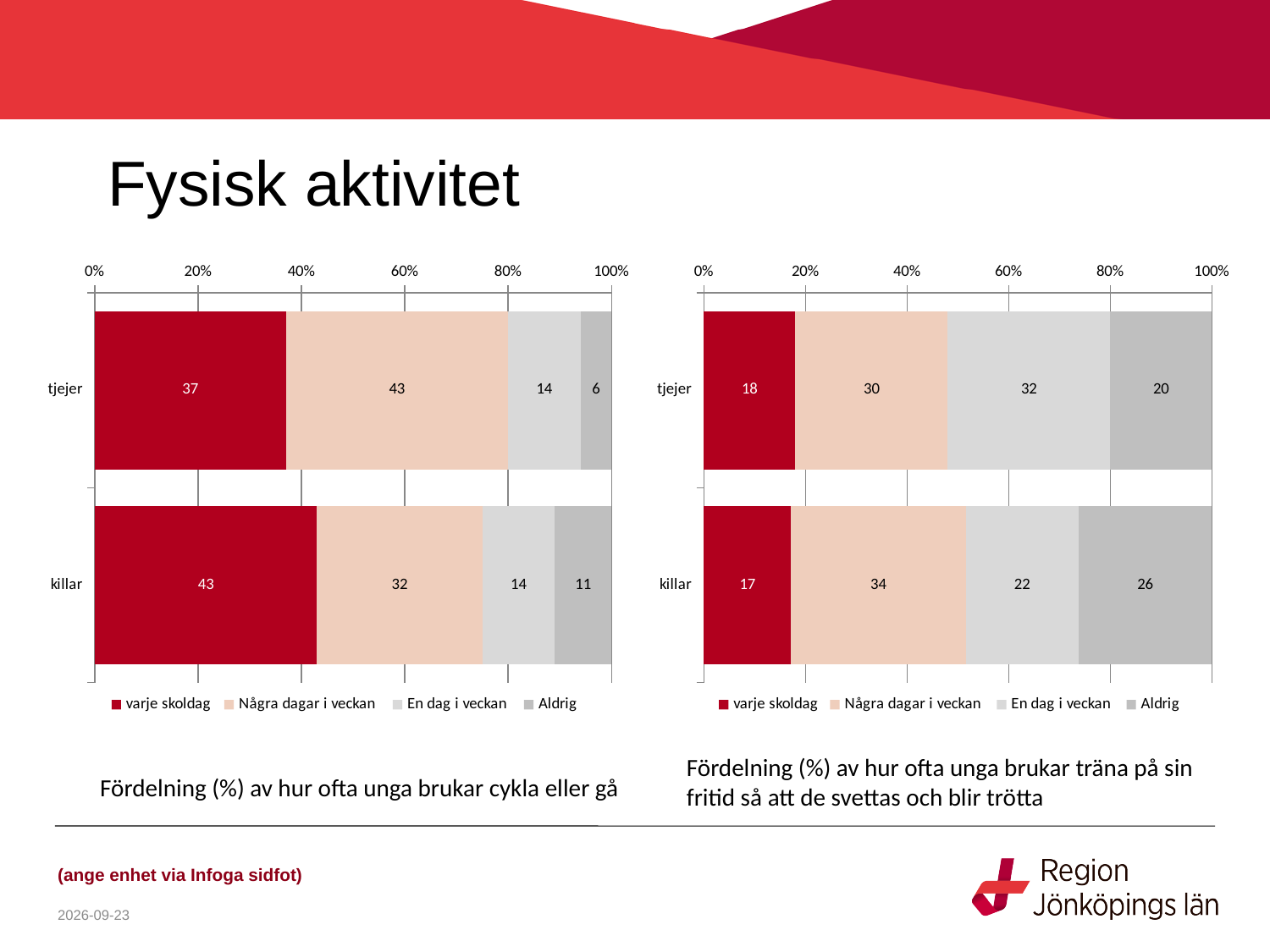
How many series does the legend of the right chart list? 4 In the left chart (cykla eller gå), which segment is the largest for tjejer? Några dagar i veckan In the left chart (cykla eller gå), what is the difference between the 'varje skoldag' values for killar and tjejer? 6 In the left chart (cykla eller gå), what is the value for 'varje skoldag' for tjejer? 37 In the right chart (träna på sin fritid), which group has the larger 'En dag i veckan' value, tjejer or killar? tjejer In the left chart (cykla eller gå), what is the value for 'Aldrig' for killar? 11 In the right chart (träna på sin fritid), which segment is the smallest for killar? varje skoldag In the right chart (träna på sin fritid), what is the value for 'En dag i veckan' for tjejer? 32 In the right chart (träna på sin fritid), what is the value for 'Några dagar i veckan' for killar? 34 In the left chart (cykla eller gå), which group has the larger 'Aldrig' value, tjejer or killar? killar What type of chart is the left chart (cykla eller gå)? Stacked bar chart In the right chart (träna på sin fritid), what is the difference between the 'Aldrig' values for killar and tjejer? 6